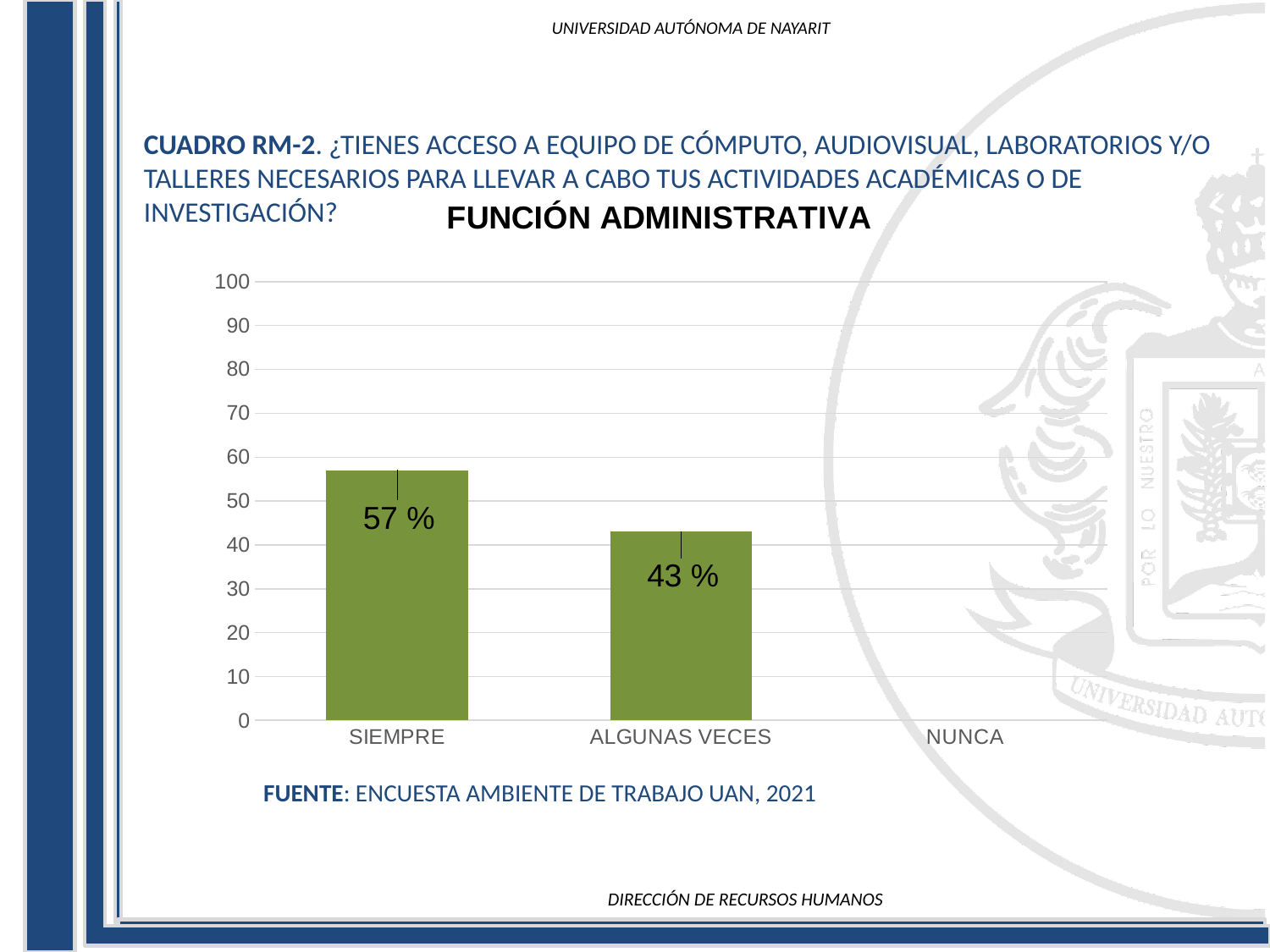
Do the values rise or fall from left to right along the x axis? fall What kind of chart is shown on the slide? bar chart What is the value for SIEMPRE? 57 % What is the difference between the values for SIEMPRE and ALGUNAS VECES? 14 % What is the title of the chart? FUNCIÓN ADMINISTRATIVA Is the value for SIEMPRE greater or less than 50? greater Is the value for ALGUNAS VECES greater or less than 50? less Which is larger, the value for SIEMPRE or the value for ALGUNAS VECES? SIEMPRE Which category has the highest value? SIEMPRE What is the value for ALGUNAS VECES? 43 % How many categories are shown on the x axis? 3